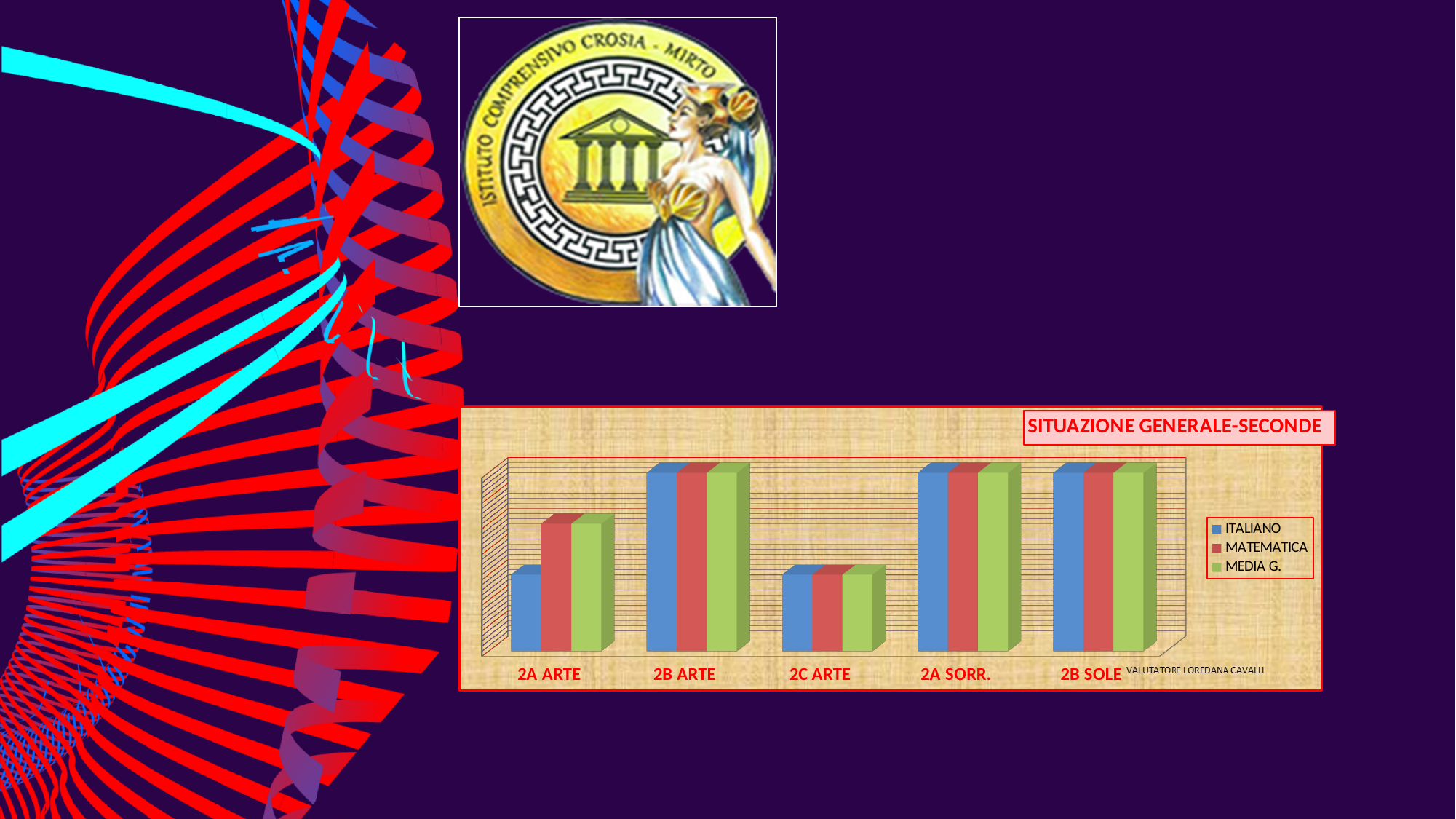
How many categories are shown on the x axis of the chart? 5 Which is larger, the MEDIA G. value for 2C ARTE or the MEDIA G. value for 2A SORR.? 2A SORR. Which series is shown in green in the chart? MEDIA G. Which is larger, the ITALIANO value for 2A ARTE or the ITALIANO value for 2B ARTE? 2B ARTE What kind of chart is shown on the slide? bar chart What is the title of the chart? SITUAZIONE GENERALE-SECONDE Which category has the lowest bars in the chart? 2C ARTE Which is larger, the MATEMATICA value for 2A ARTE or the MATEMATICA value for 2C ARTE? 2A ARTE How many series does the chart's legend list? 3